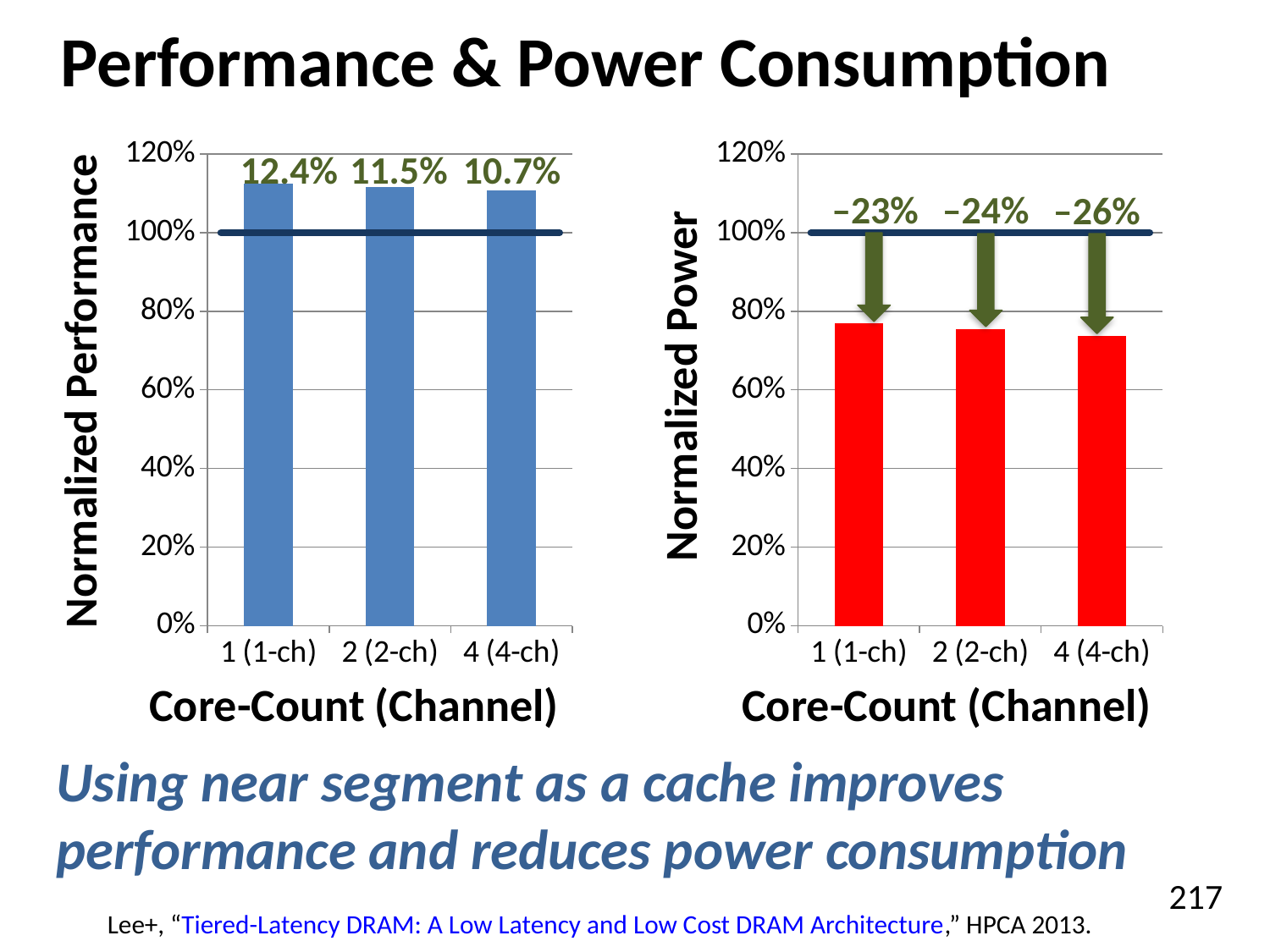
How many core-count categories are shown on the x axis of the Normalized Power chart on the right? 3 In the Normalized Performance chart on the left, what is the difference between the printed labels for 1 (1-ch) and 4 (4-ch)? 1.7% In the Normalized Power chart on the right, what percentage label is printed above the bar for 4 (4-ch)? –26% In the Normalized Power chart on the right, is the bar for 1 (1-ch) greater or less than 80%? less In the Normalized Power chart on the right, which core-count category has the largest printed power reduction? 4 (4-ch) In the Normalized Power chart on the right, what percentage label is printed above the bar for 2 (2-ch)? –24% What kind of chart is the Normalized Performance chart on the left? bar chart In the Normalized Power chart on the right, do the bar heights rise or fall as core-count increases from 1 (1-ch) to 4 (4-ch)? fall In the Normalized Performance chart on the left, what percentage label is printed above the bar for 4 (4-ch)? 10.7% In the Normalized Performance chart on the left, what percentage label is printed above the bar for 1 (1-ch)? 12.4% In the Normalized Performance chart on the left, is the bar for 2 (2-ch) greater or less than 100%? greater In the Normalized Performance chart on the left, which core-count category has the largest printed improvement percentage? 1 (1-ch)